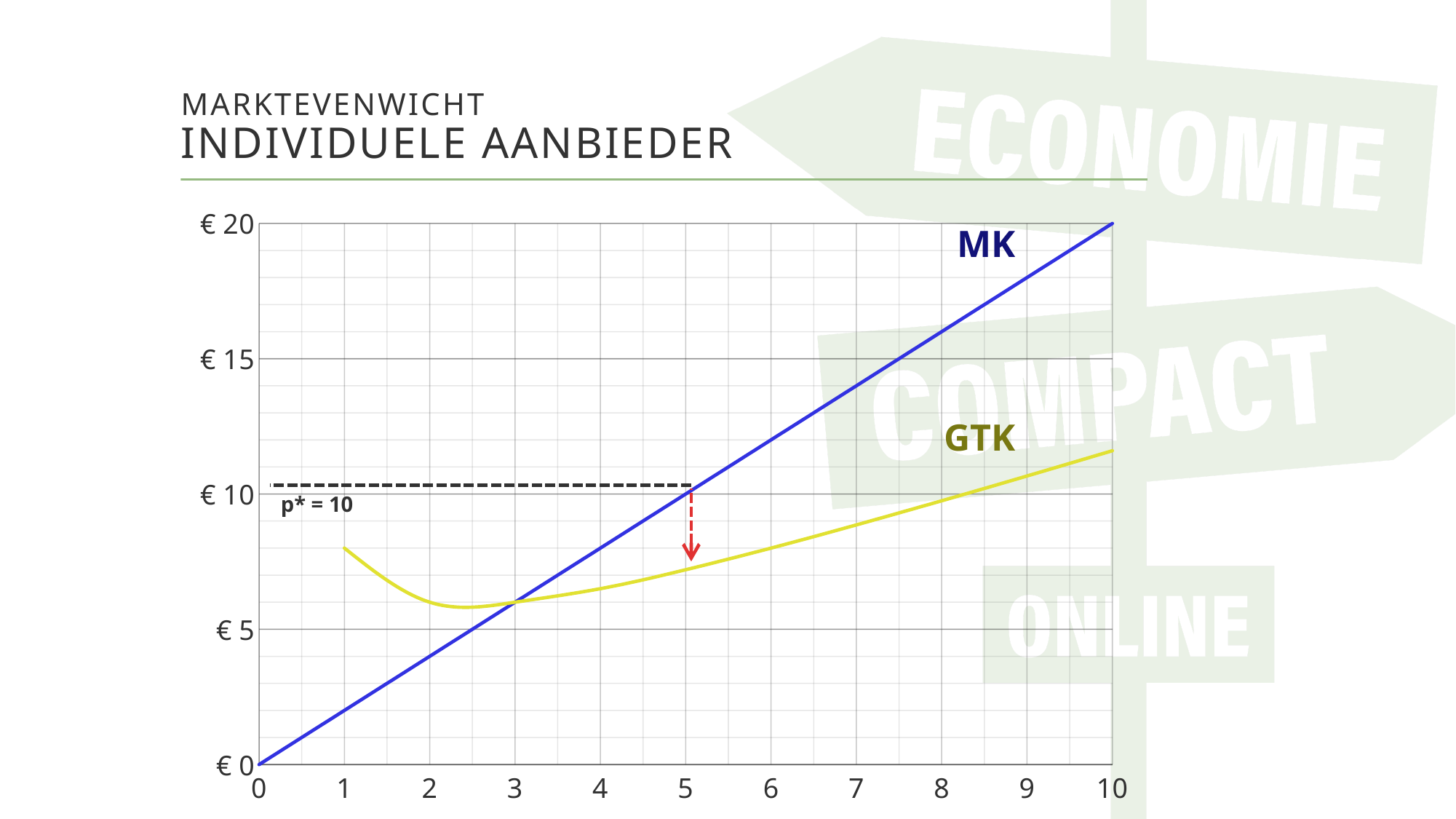
What is the value of MK at quantity 10? € 20 Does the MK line rise or fall as quantity increases along the x axis? rises At quantity 1, which curve is higher, MK or GTK? GTK At which quantity does the MK line reach the dashed p* = 10 line? 5 Is the value of GTK at quantity 5 greater or less than € 10? less Is the value of GTK at quantity 10 greater or less than € 15? less What equilibrium price p* is marked on the chart? 10 At quantity 8, which curve is higher, MK or GTK? MK How many curves are labelled on the chart? 2 Is the value of MK at quantity 8 greater or less than € 15? greater What kind of chart is shown on the slide? line chart What is the value of MK at quantity 0? € 0